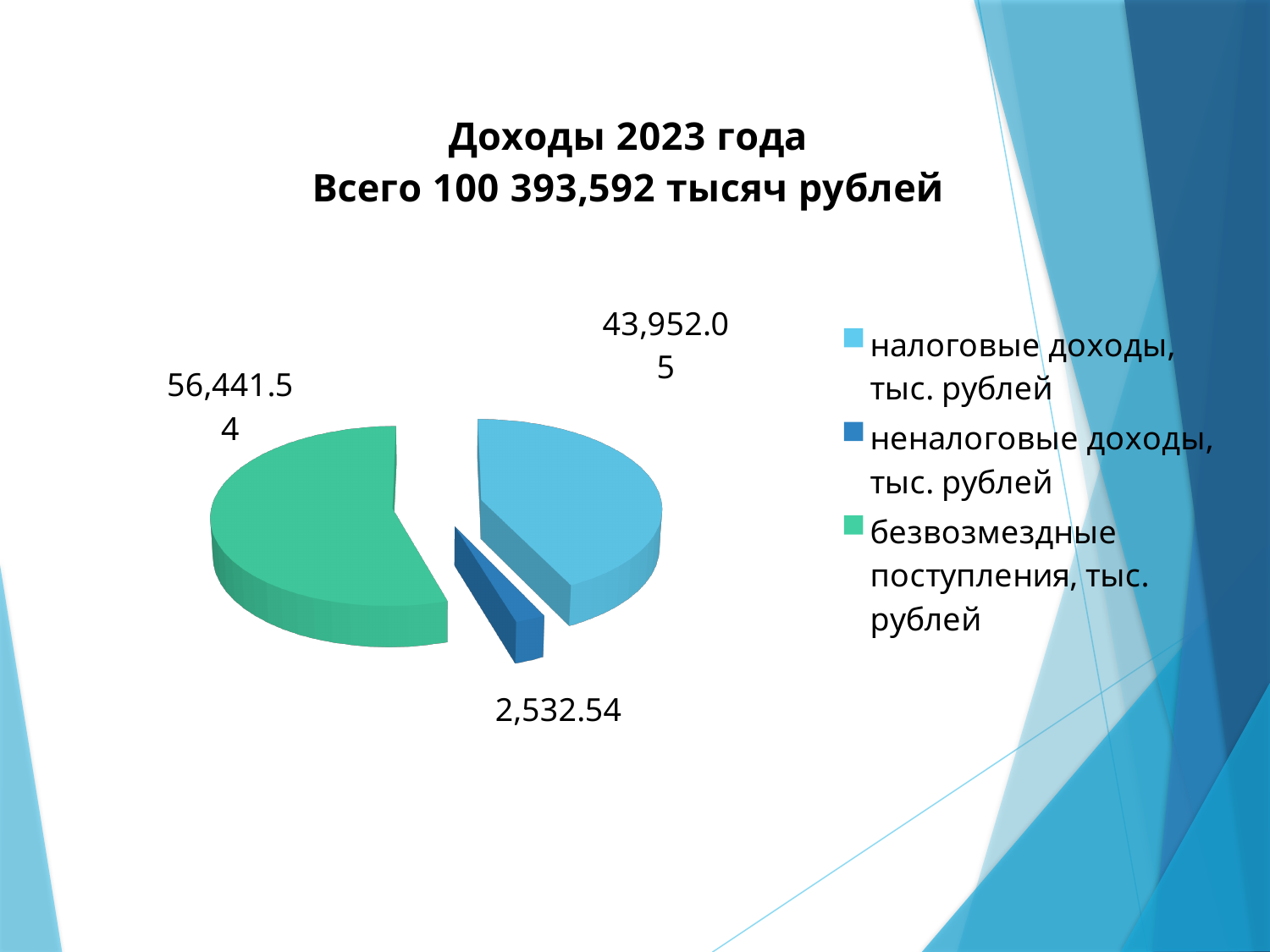
What is the value for безвозмездные поступления, тыс. рублей? 56,441.54 How many slices does the pie chart have? 3 What is the difference between налоговые доходы and неналоговые доходы? 41,419.51 How many entries does the legend list? 3 What kind of chart is shown on the slide? pie chart What is the value for неналоговые доходы, тыс. рублей? 2,532.54 What is the difference between безвозмездные поступления and налоговые доходы? 12,489.49 Which category has the smallest slice of the pie? неналоговые доходы, тыс. рублей Which category has the largest slice of the pie? безвозмездные поступления, тыс. рублей What is the value for налоговые доходы, тыс. рублей? 43,952.05 Which is larger: налоговые доходы or безвозмездные поступления? безвозмездные поступления What is the title of the chart? Доходы 2023 года Всего 100 393,592 тысяч рублей